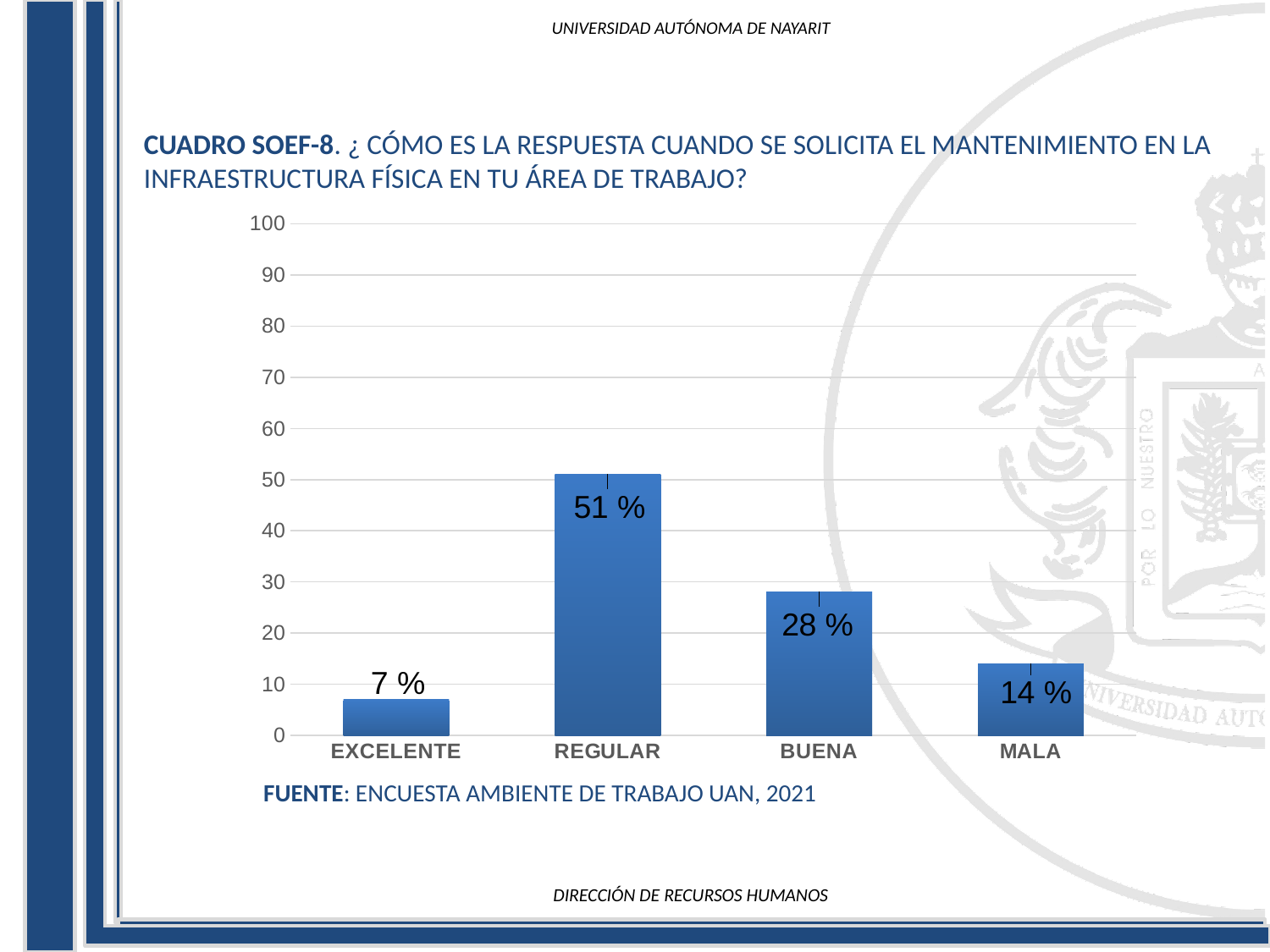
How many categories are shown on the x axis? 4 Which category has the highest value? REGULAR Which category has the lowest value? EXCELENTE What is the value for EXCELENTE? 7 % What is the value for REGULAR? 51 % What is the value for BUENA? 28 % What is the source cited below the chart? ENCUESTA AMBIENTE DE TRABAJO UAN, 2021 What is the difference between the values for REGULAR and BUENA? 23 % What kind of chart is shown on the slide? bar chart What is the value for MALA? 14 % Is the value for REGULAR greater or less than 50? greater Which is larger, the value for BUENA or the value for MALA? BUENA